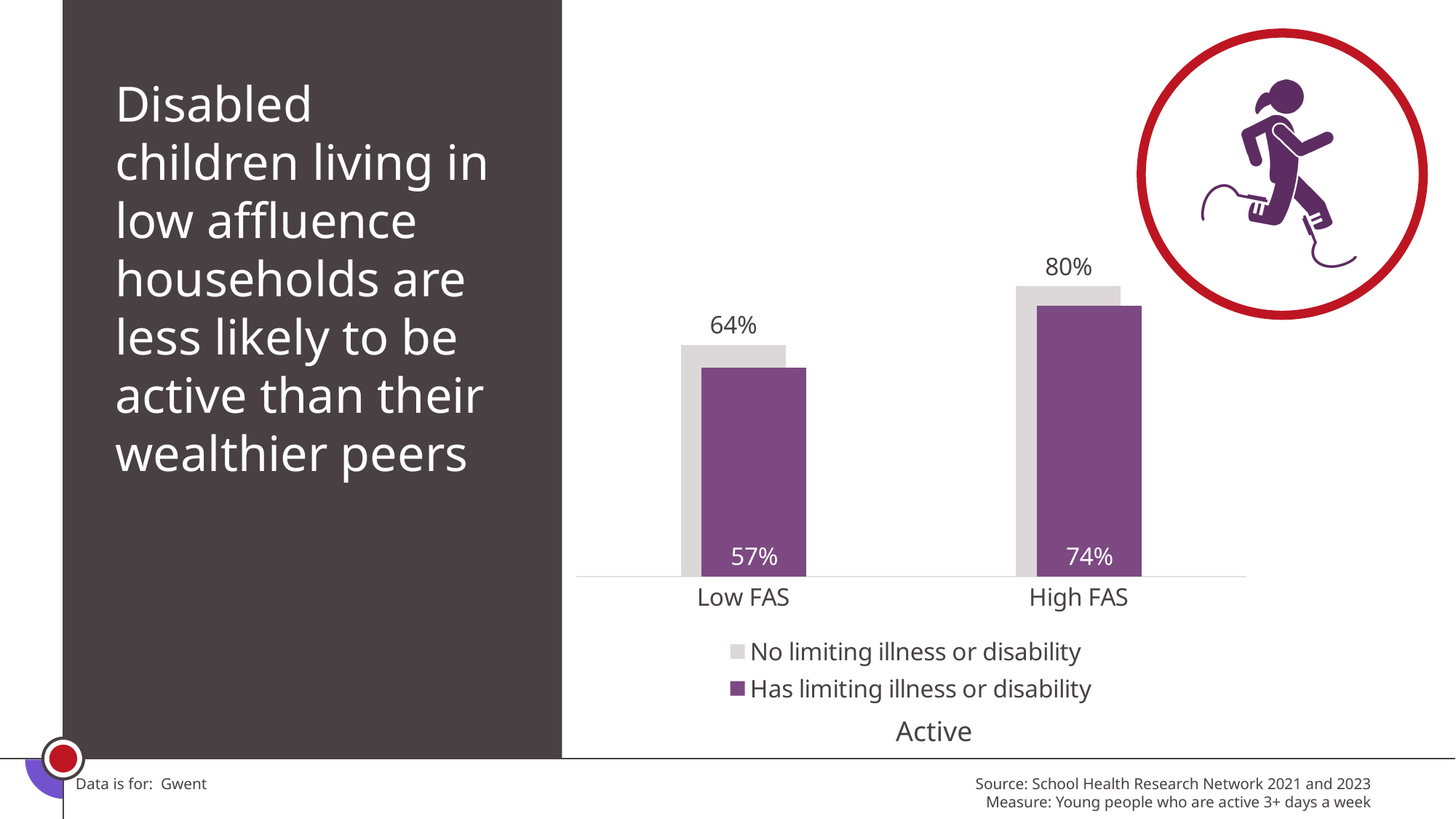
What is the difference between 'No limiting illness or disability' and 'Has limiting illness or disability' in the Low FAS category? 7% What is the value for 'Has limiting illness or disability' in the Low FAS category? 57% Which is larger in the High FAS category: 'No limiting illness or disability' or 'Has limiting illness or disability'? No limiting illness or disability What is the value for 'Has limiting illness or disability' in the High FAS category? 74% What is the value for 'No limiting illness or disability' in the Low FAS category? 64% Which category has the lowest value for 'No limiting illness or disability'? Low FAS How many categories are shown on the x axis? 2 What is the difference between the High FAS and Low FAS values for 'Has limiting illness or disability'? 17% What kind of chart is shown on the slide? Bar chart Which category has the highest value for 'Has limiting illness or disability'? High FAS How many series does the legend list? 2 What is the value for 'No limiting illness or disability' in the High FAS category? 80%